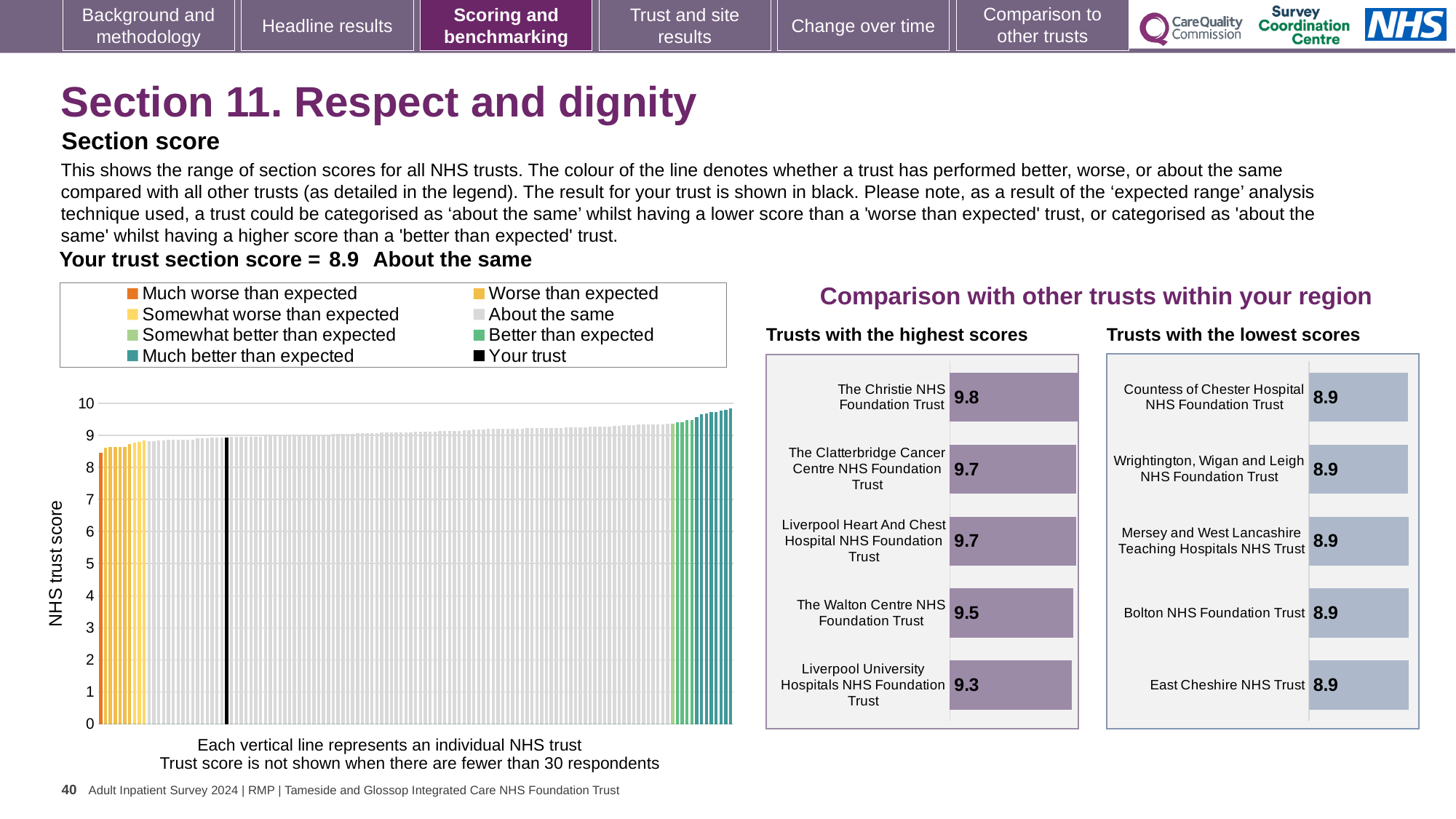
In the large chart on the left, is the value of the leftmost (orange) bar greater or less than 9? less In the large chart on the left, is the value of the rightmost bar greater or less than 9? greater In the 'Trusts with the highest scores' chart, what is the difference between the scores of The Christie NHS Foundation Trust and The Walton Centre NHS Foundation Trust? 0.3 In the large chart on the left, do the bar values rise or fall from left to right along the x axis? rise In the 'Trusts with the lowest scores' chart, what is the score for Bolton NHS Foundation Trust? 8.9 What kind of chart is the large chart on the left showing NHS trust scores? bar chart In the large chart on the left, what is the label on the vertical axis? NHS trust score In the 'Trusts with the highest scores' chart, what is the score for The Christie NHS Foundation Trust? 9.8 In the large chart on the left, how many entries does the legend list? 8 In the 'Trusts with the highest scores' chart, which trust has the lowest score? Liverpool University Hospitals NHS Foundation Trust In the 'Trusts with the highest scores' chart, how many trusts are shown? 5 In the 'Trusts with the highest scores' chart, which is larger: the score for The Clatterbridge Cancer Centre NHS Foundation Trust or the score for Liverpool University Hospitals NHS Foundation Trust? The Clatterbridge Cancer Centre NHS Foundation Trust